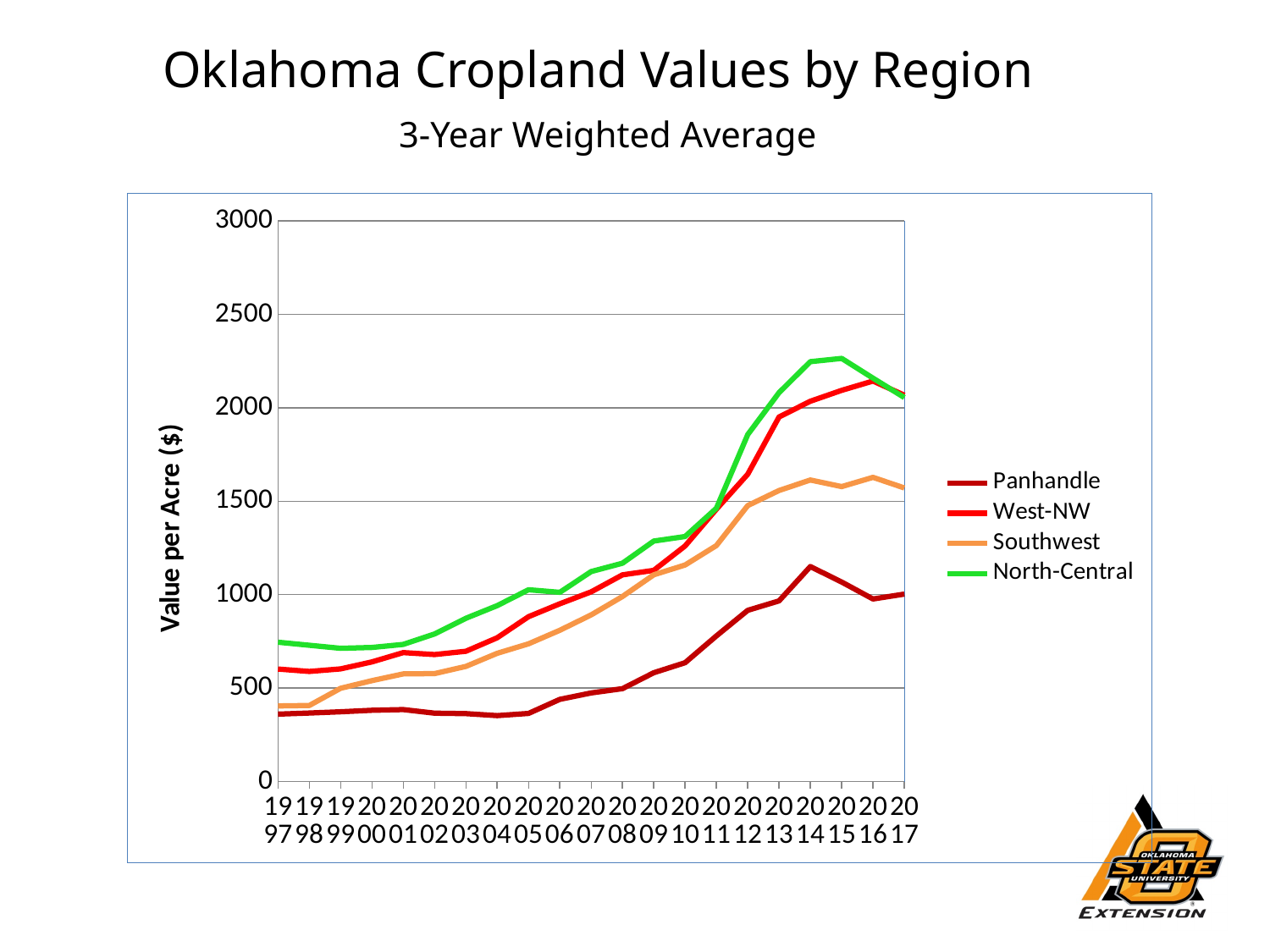
Which region has the lowest cropland value in 2017? Panhandle Is the value for West-NW in 1997 greater or less than 500? greater Does the North-Central value rise or fall from 2015 to 2017? fall What is the title of the y axis? Value per Acre ($) Does the Panhandle value rise or fall from 1997 to 2014? rise What kind of chart is shown on the slide? line chart How many series does the legend list? 4 How many years are plotted along the x axis? 21 Is the value for Southwest in 2016 greater or less than 1500? greater Which region has the highest cropland value in 2015? North-Central Is the value for Panhandle in 2014 greater or less than 1000? greater Which is larger in 2012, the value for West-NW or the value for Southwest? West-NW